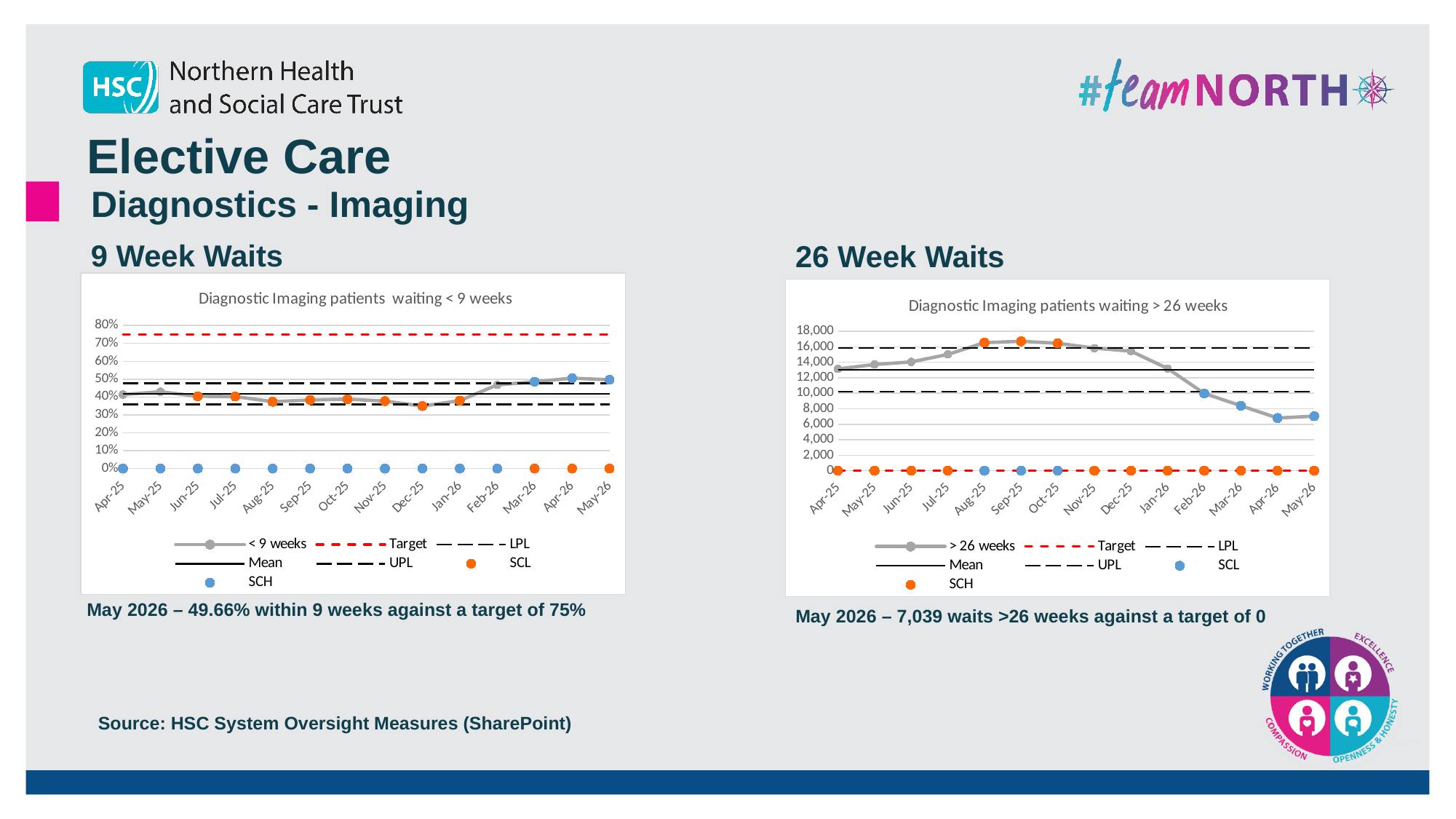
On the 26 Week Waits chart, which is larger, the value for Feb-26 or the value for Apr-26? Feb-26 What kind of chart is the 9 Week Waits chart (Diagnostic Imaging patients waiting < 9 weeks)? Line chart On the 9 Week Waits chart, is the value for Dec-25 greater or less than 40%? less On the 26 Week Waits chart, what is the target value? 0 How many series does the legend of the 9 Week Waits chart list? 7 On the 9 Week Waits chart, what is the target value? 75% What is the title of the chart under the 9 Week Waits heading? Diagnostic Imaging patients waiting < 9 weeks On the 26 Week Waits chart, is the value for Sep-25 greater or less than 16,000? greater How many monthly data points are plotted on the x axis of the 26 Week Waits chart? 14 On the 26 Week Waits chart, what is the number of waits for May 2026 as stated on the slide? 7,039 On the 26 Week Waits chart, do the values rise or fall between Sep-25 and Apr-26? fall On the 9 Week Waits chart, what is the value for May 2026 as stated on the slide? 49.66%